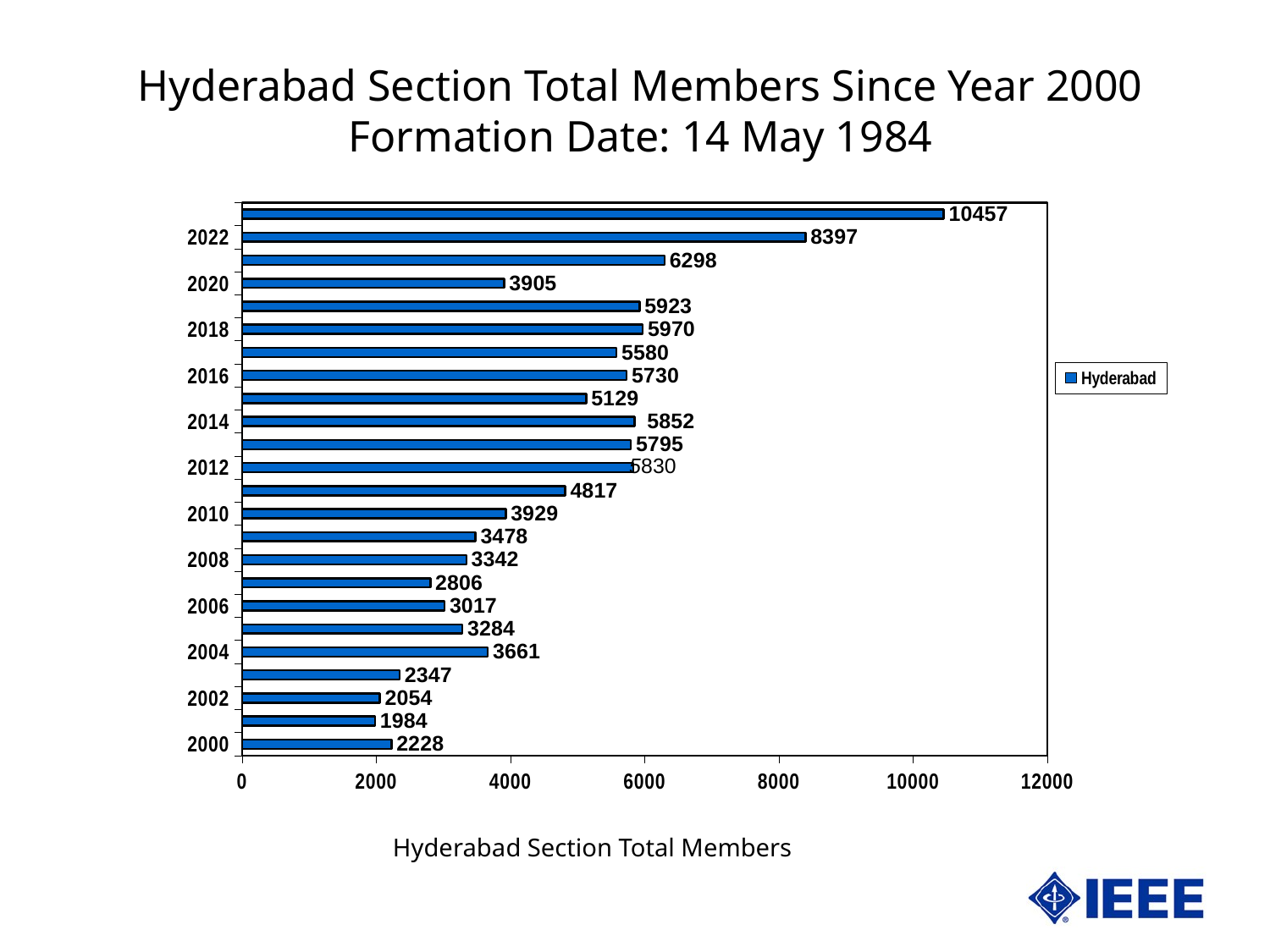
What kind of chart is shown? Bar chart What is the value for 2000? 2228 What is the value for 2020? 3905 What is the difference between the values for 2022 and 2020? 4492 Which year has the highest number of members? 2023 What is the lowest value shown on the chart? 1984 What series name does the legend show? Hyderabad How many bars are plotted on the chart? 24 What is the highest value shown on the chart? 10457 Which is larger, the value for 2018 or the value for 2016? 2018 What is the value for 2022? 8397 What is the value for 2010? 3929